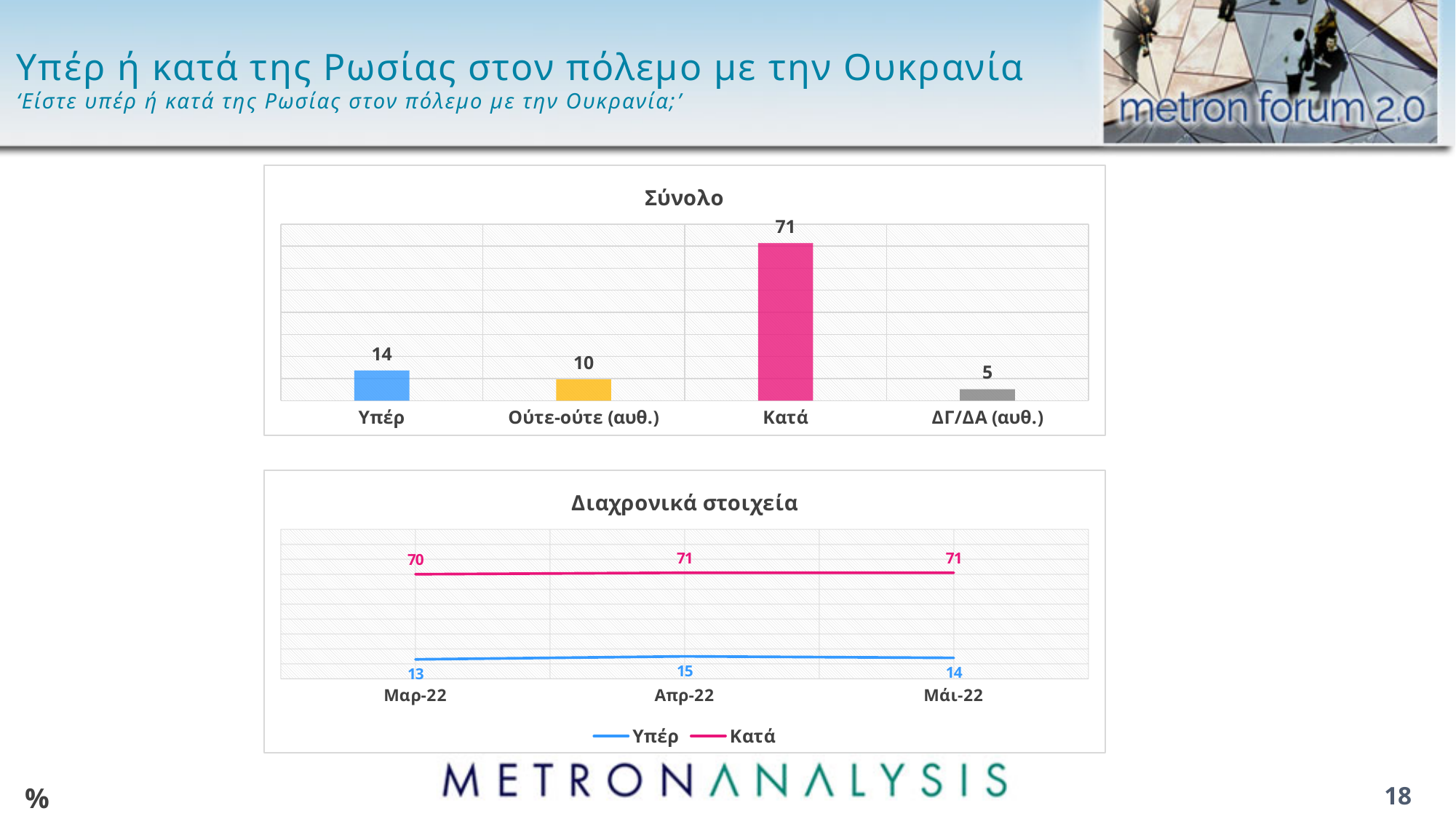
In the 'Σύνολο' chart, which category has the lowest value? ΔΓ/ΔΑ (αυθ.) In the 'Διαχρονικά στοιχεία' chart, what is the value for Υπέρ in Απρ-22? 15 In the 'Σύνολο' chart, how many categories are shown? 4 What kind of chart is the 'Διαχρονικά στοιχεία' chart? Line chart In the 'Σύνολο' chart, which category has the highest value? Κατά In the 'Διαχρονικά στοιχεία' chart, what is the value for Κατά in Μαρ-22? 70 In the 'Διαχρονικά στοιχεία' chart, how many series does the legend list? 2 What kind of chart is the 'Σύνολο' chart? Bar chart In the 'Σύνολο' chart, what is the value for Υπέρ? 14 In the 'Διαχρονικά στοιχεία' chart, which is larger in Μάι-22, Υπέρ or Κατά? Κατά In the 'Σύνολο' chart, what is the difference between Κατά and Υπέρ? 57 In the 'Σύνολο' chart, what is the value for Κατά? 71